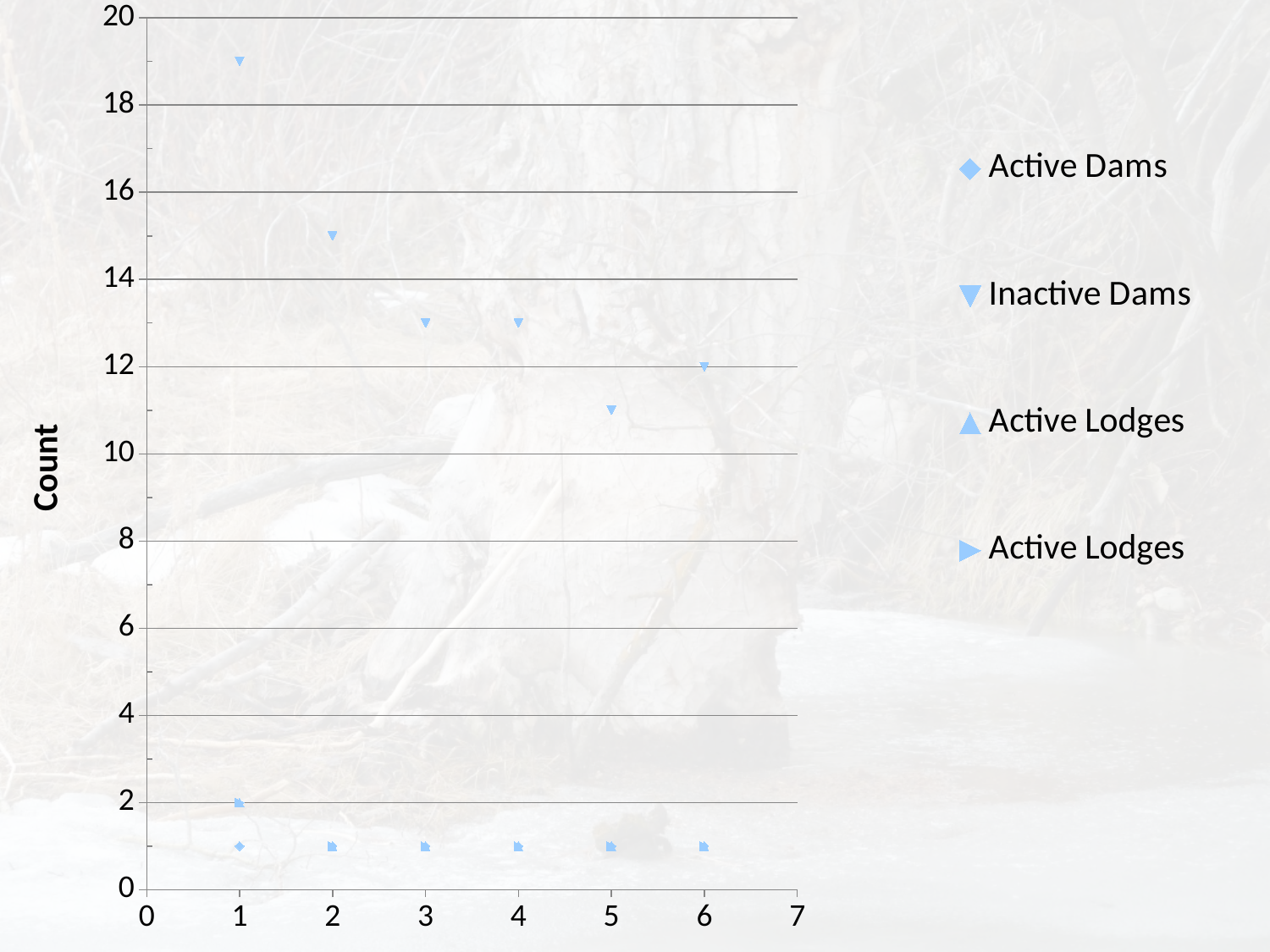
Which is larger for Inactive Dams: the value at x = 1 or the value at x = 2? x = 1 Is the Inactive Dams value at x = 1 greater or less than 18? greater At which x value is the Inactive Dams series highest? 1 Is the Inactive Dams value at x = 2 greater or less than 16? less Which legend label appears twice in the legend? Active Lodges What kind of chart is shown on the slide? scatter chart What is the Inactive Dams value at x = 6? 12 How many series does the legend list? 4 At which x value is the Inactive Dams series lowest? 5 What is the title of the vertical axis? Count How many Inactive Dams points are plotted? 6 Do the Inactive Dams values generally rise or fall from x = 1 to x = 6? fall